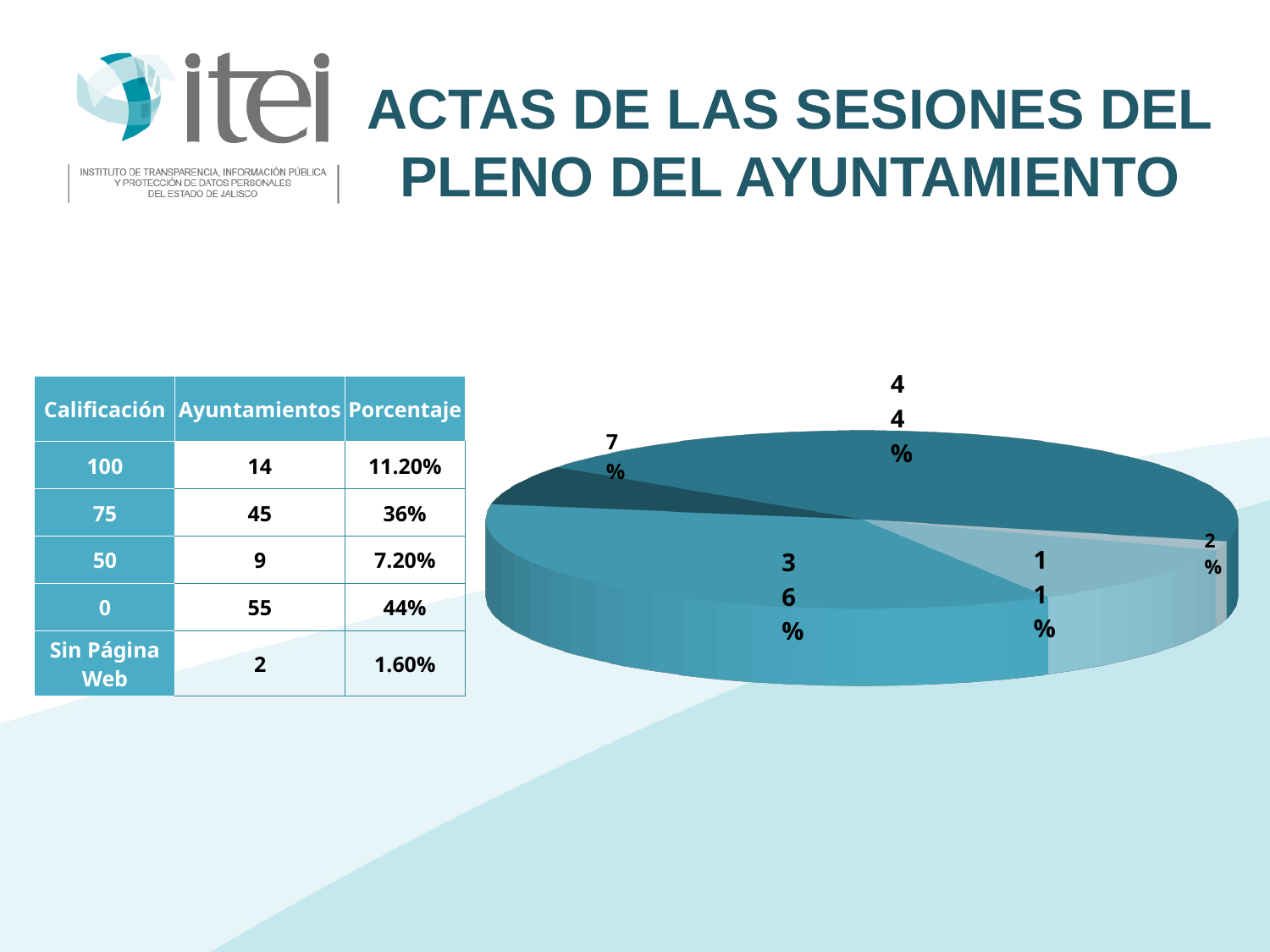
What is the difference in percentage points between the slice labelled 44% and the slice labelled 36%? 8 What kind of chart is shown on the slide? pie chart What is the sum of all the percentage labels shown on the pie chart? 100% Is the largest slice of the pie chart greater or less than 40%? greater Is the slice labelled 7% larger or smaller than the slice labelled 11%? smaller How many slices does the pie chart have? 5 Does the pie chart display a legend? No What is the percentage label on the smallest slice of the pie chart? 2% What is the difference in percentage points between the slice labelled 11% and the slice labelled 7%? 4 Which is larger in the pie chart, the slice labelled 36% or the slice labelled 11%? 36% What is the percentage label on the largest slice of the pie chart? 44% What is the second-largest percentage label shown on the pie chart? 36%